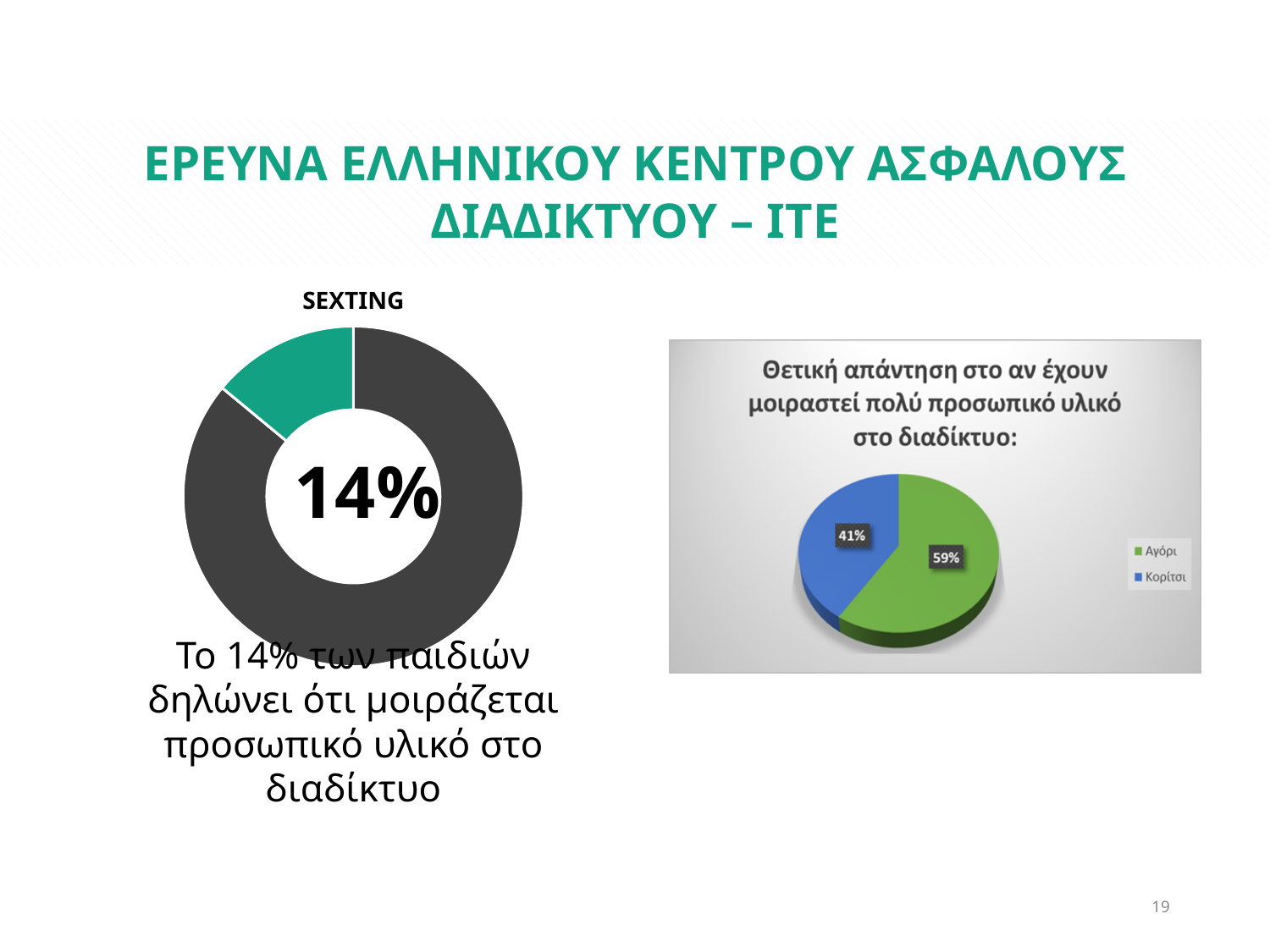
In the pie chart on the right, is the value for Αγόρι greater or less than 50%? greater How many categories does the legend of the pie chart on the right list? 2 What is the title of the doughnut chart on the left of the slide? SEXTING In the pie chart on the right, which category has the larger share, Αγόρι or Κορίτσι? Αγόρι In the pie chart on the right, what is the value for Κορίτσι? 41% In the pie chart on the right, what is the difference between the Αγόρι and Κορίτσι values? 18% What percentage is shown in the centre of the SEXTING doughnut chart? 14% What kind of chart is the SEXTING chart on the left of the slide? Doughnut chart What kind of chart is the chart on the right of the slide? Pie chart In the pie chart on the right, which category has the smallest slice? Κορίτσι In the pie chart on the right, what colour is the Κορίτσι slice? Blue In the pie chart on the right, what is the value for Αγόρι? 59%